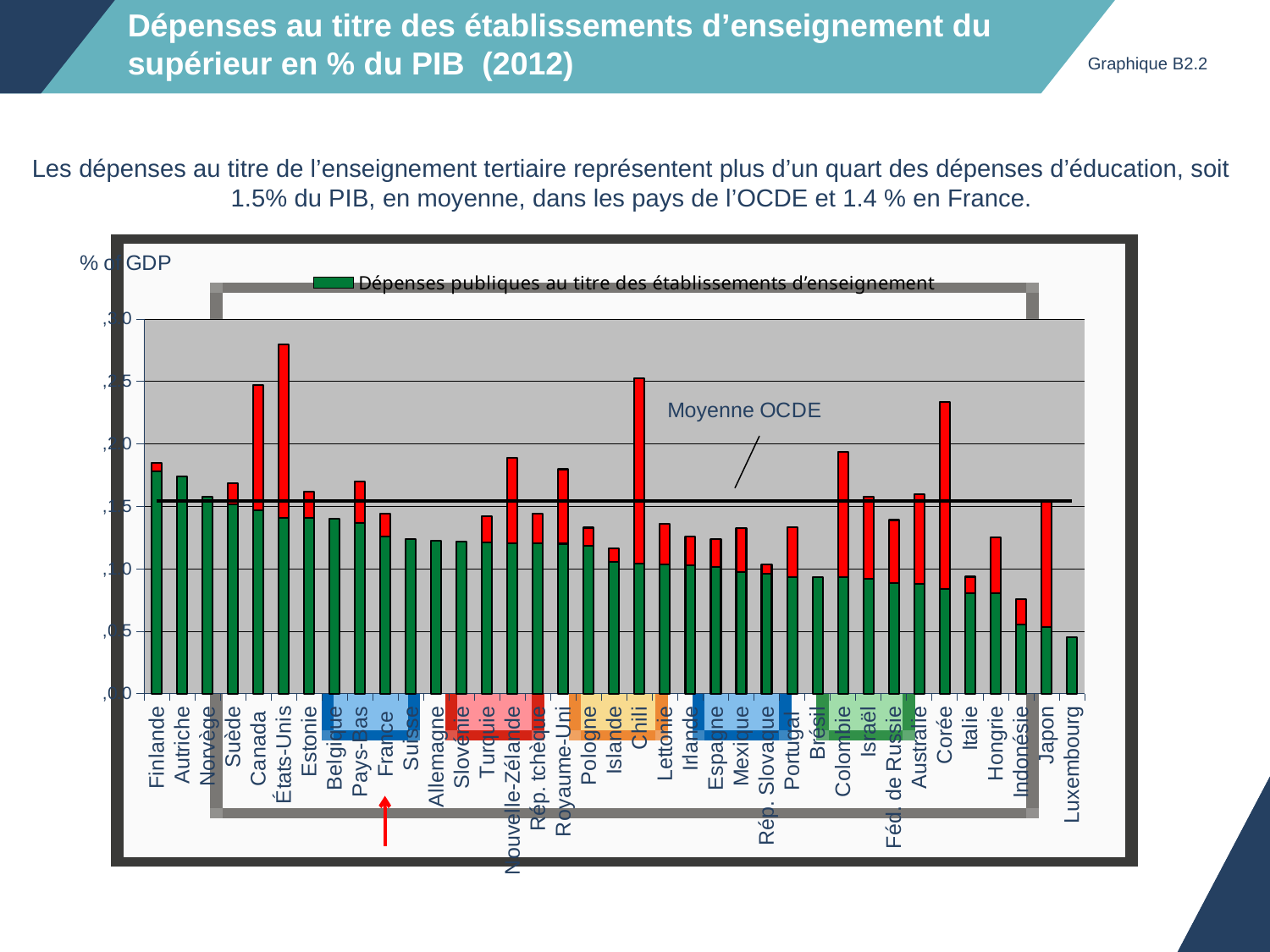
Which country has the shortest total bar in the chart? Luxembourg Which country is marked with a red arrow below the x axis? France What does the horizontal black line across the chart represent? Moyenne OCDE How many countries are shown on the x axis of the chart? 37 Which has the larger total bar, Brésil or Colombie? Colombie Which has the larger total bar, Canada or États-Unis? États-Unis What is the graph number shown in the top right corner of the slide? Graphique B2.2 Which has the larger total bar, Japon or Luxembourg? Japon Which country has the tallest total bar in the chart? États-Unis What kind of chart is shown on the slide? Stacked bar chart Which country has the tallest green (public expenditure) portion in the chart? Finlande